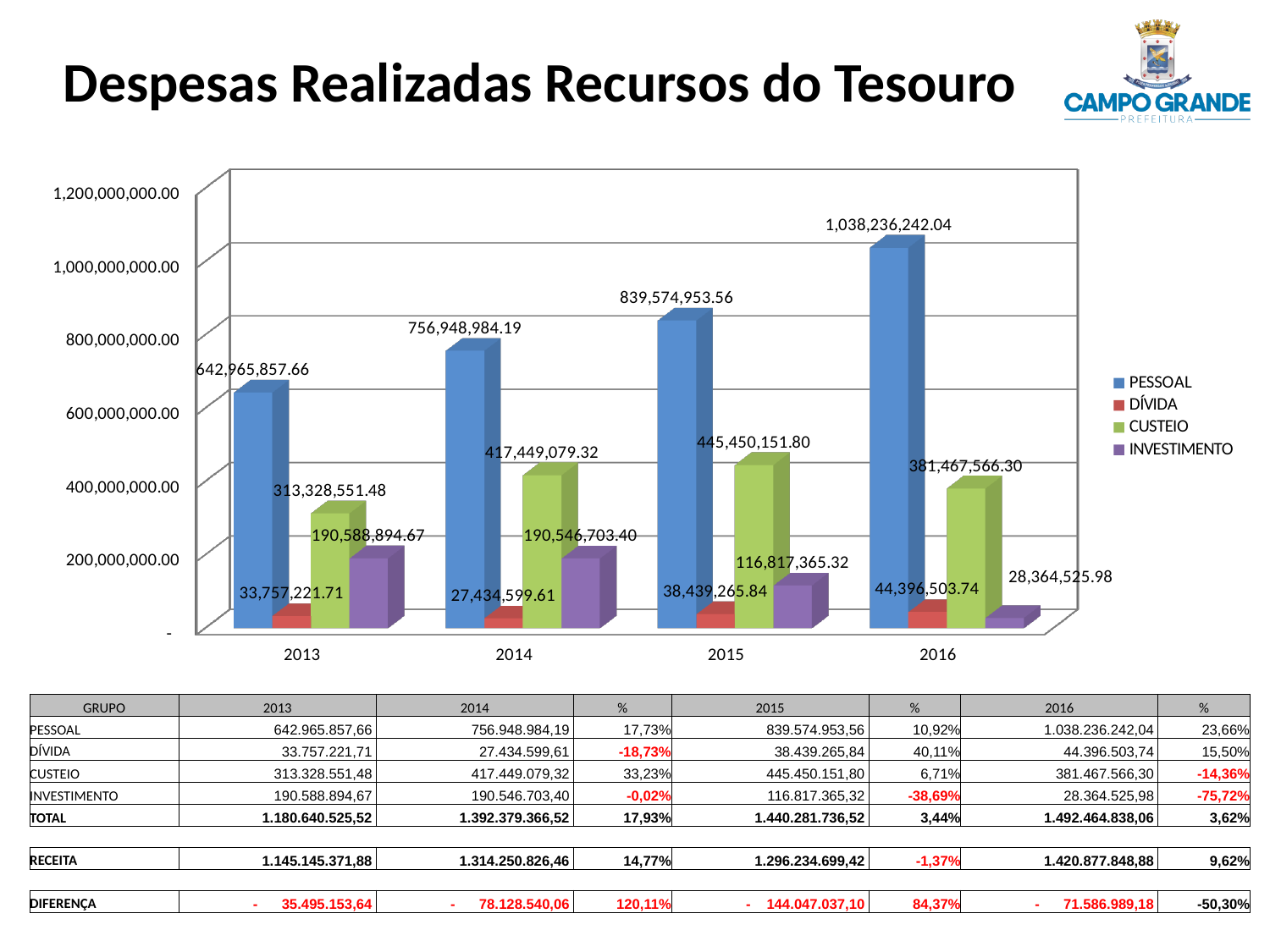
What is the value for CUSTEIO in 2014? 417,449,079.32 What is the difference between the PESSOAL values for 2016 and 2015? 198,661,288.48 In which year is the PESSOAL value highest? 2016 How many years are shown on the x axis of the chart? 4 What is the value for PESSOAL in 2016? 1,038,236,242.04 What is the value for INVESTIMENTO in 2015? 116,817,365.32 What is the value for DÍVIDA in 2013? 33,757,221.71 Which is larger, the CUSTEIO value for 2014 or for 2016? 2014 Does the PESSOAL value rise or fall from 2013 to 2016? rise In which year is the INVESTIMENTO value lowest? 2016 How many series does the legend list? 4 Is the value for PESSOAL in 2016 greater or less than 1,000,000,000.00? greater